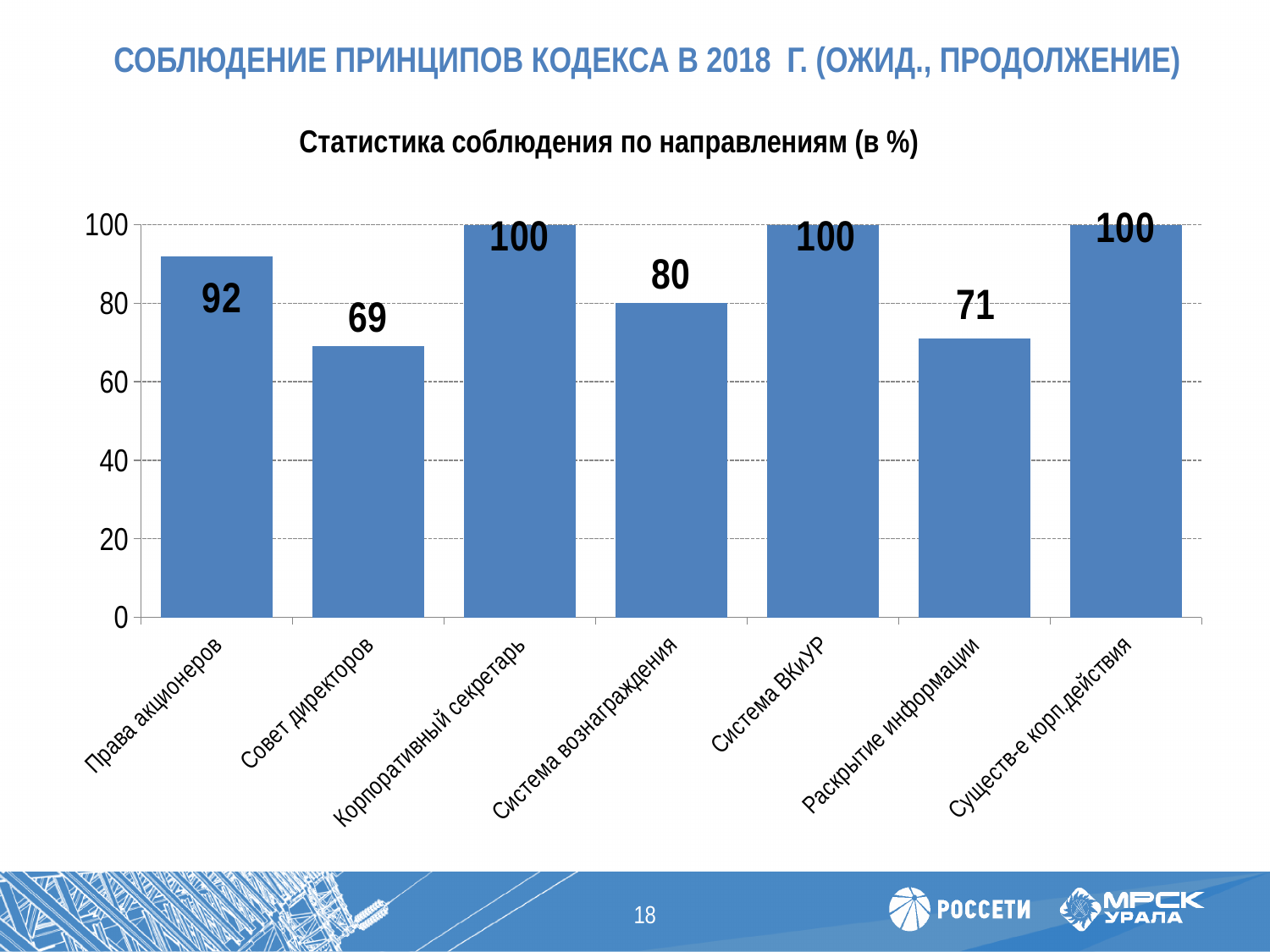
What is the value for Система вознаграждения? 80 What is the title of the chart? Статистика соблюдения по направлениям (в %) What kind of chart is shown on the slide? bar chart What is the difference between the values for Права акционеров and Совет директоров? 23 Is the value for Совет директоров greater or less than 80? less What is the value for Раскрытие информации? 71 How many categories are shown on the chart? 7 What is the value for Совет директоров? 69 What is the difference between the values for Система вознаграждения and Раскрытие информации? 9 Which category has the lowest value? Совет директоров What is the value for Права акционеров? 92 Which is larger, the value for Права акционеров or the value for Система вознаграждения? Права акционеров